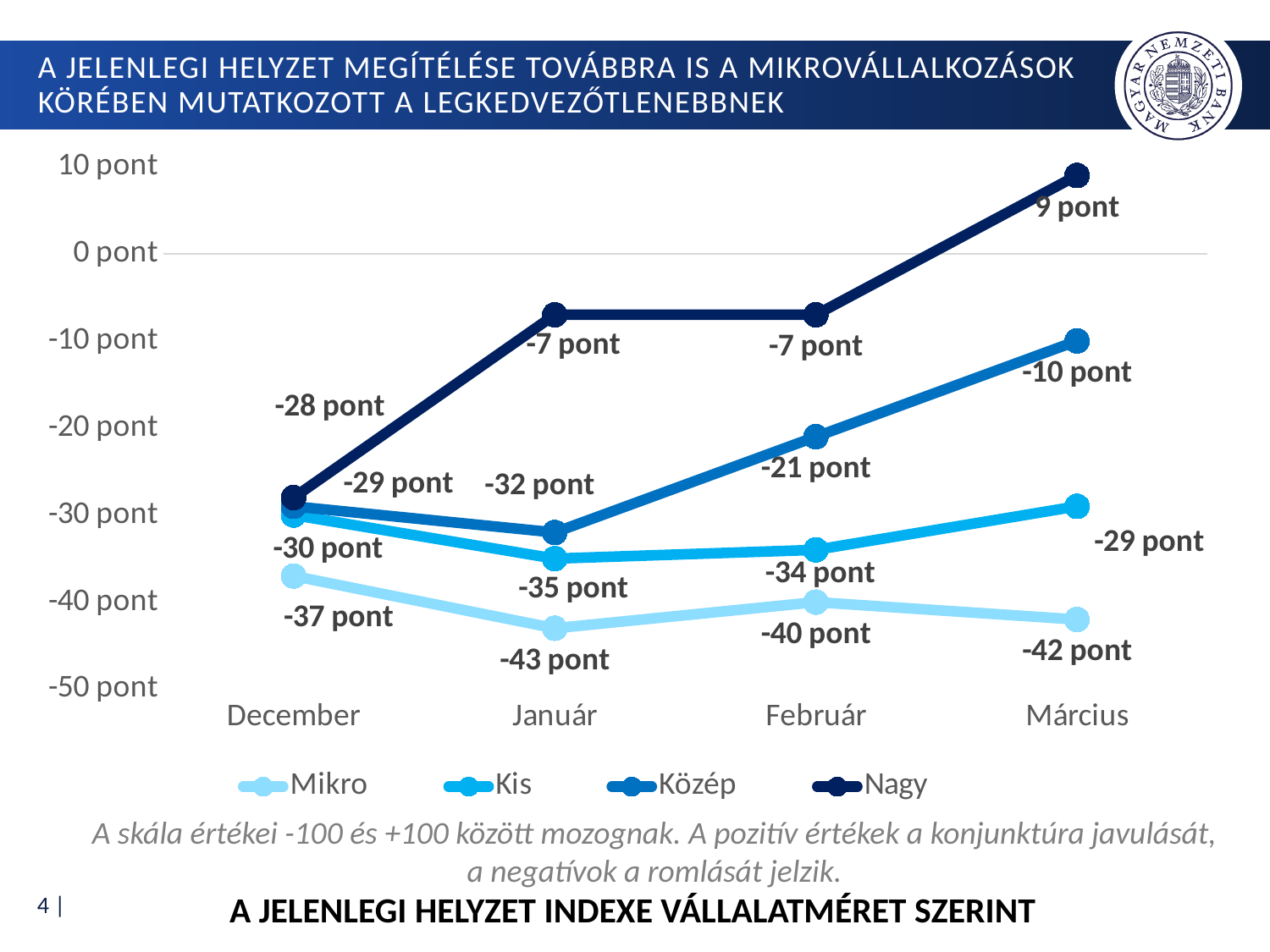
What is the difference between the Nagy and Mikro values in Március? 51 pont What kind of chart is shown on the slide? line chart Does the Nagy series rise or fall from December to Március? rise Which is larger in Február, the value for Közép or the value for Kis? Közép What is the value for Nagy in Március? 9 pont Which series has the highest value in Március? Nagy How many months are shown on the x axis? 4 What is the value for Közép in Február? -21 pont What is the value for Kis in Március? -29 pont Which series has the lowest value in Január? Mikro What is the value for Mikro in Január? -43 pont How many series does the legend list? 4